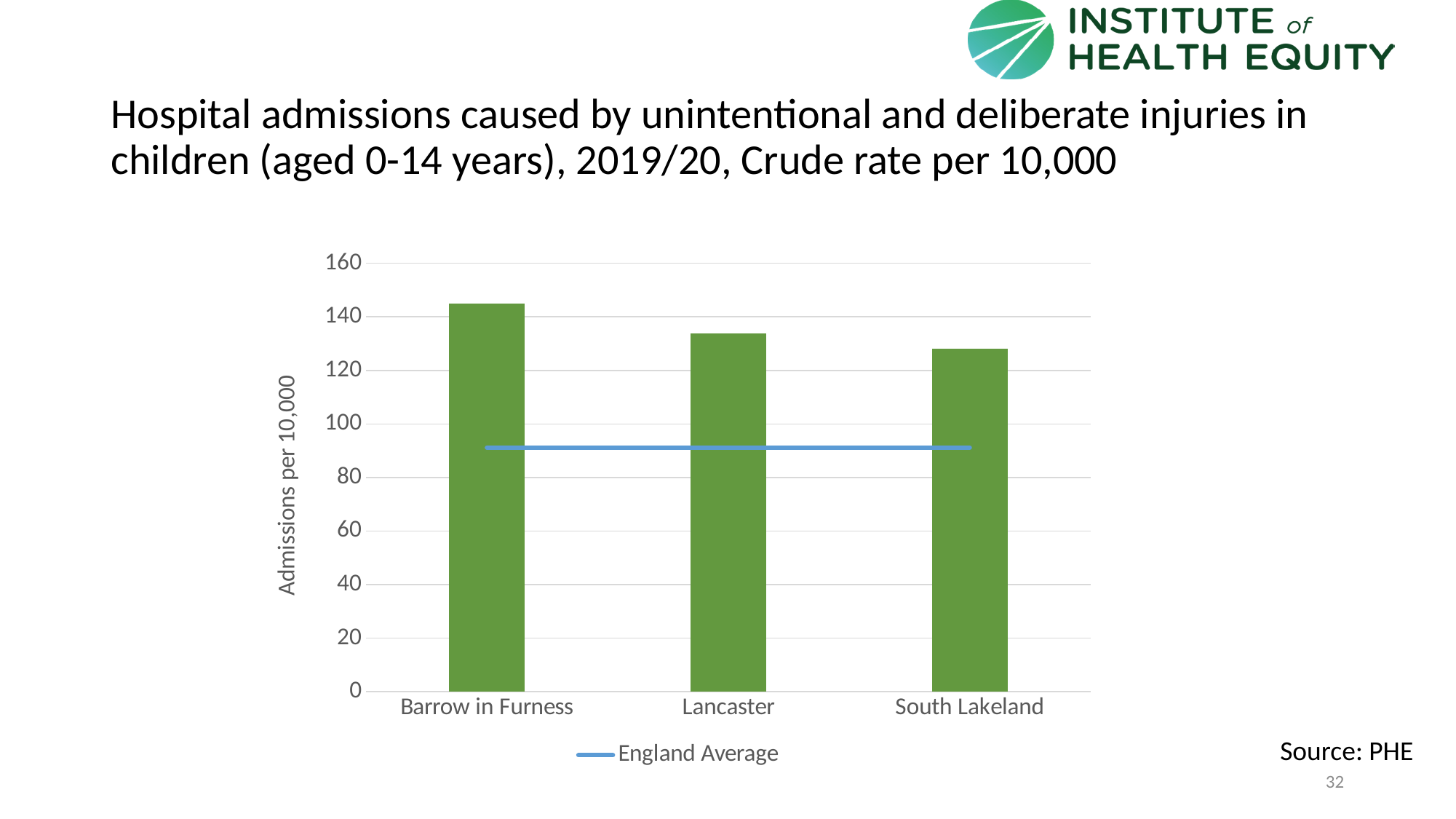
How many entries does the legend list? 1 How many local areas are shown as bars on the chart? 3 What is the label on the vertical axis of the chart? Admissions per 10,000 Which area has the lowest rate of hospital admissions for injuries in children? South Lakeland Is the value for Barrow in Furness greater or less than 140? greater Is the England Average line greater or less than 100? less Do the bar values rise or fall from left to right across the chart? fall What kind of chart is shown on the slide? combination bar and line chart Which area has the highest rate of hospital admissions for injuries in children? Barrow in Furness Which has the larger value, Lancaster or South Lakeland? Lancaster Is the value for South Lakeland greater or less than 120? greater